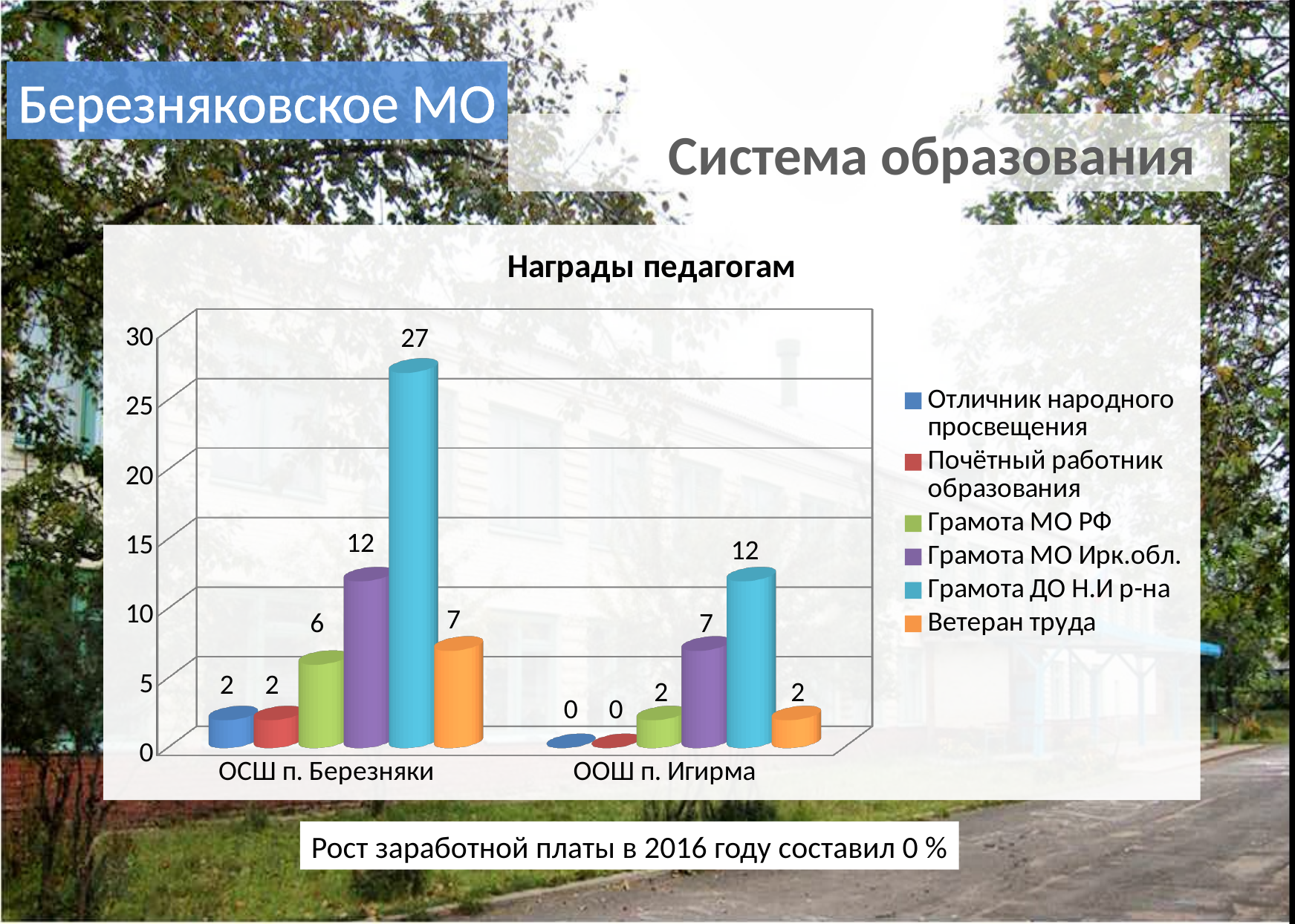
What is the value for Грамота МО Ирк.обл. at ООШ п. Игирма? 7 What is the title of the chart? Награды педагогам Which award has the highest value at ОСШ п. Березняки? Грамота ДО Н.И р-на Which is larger: Грамота МО РФ at ОСШ п. Березняки or Грамота МО РФ at ООШ п. Игирма? ОСШ п. Березняки How many series does the legend list? 6 What is the value for Ветеран труда at ОСШ п. Березняки? 7 What is the value for Грамота ДО Н.И р-на at ОСШ п. Березняки? 27 What is the value for Отличник народного просвещения at ООШ п. Игирма? 0 How many categories are shown on the x axis? 2 Is the value for Грамота ДО Н.И р-на at ОСШ п. Березняки greater or less than 25? greater What is the difference between Грамота ДО Н.И р-на at ОСШ п. Березняки and at ООШ п. Игирма? 15 What type of chart is shown on the slide? bar chart